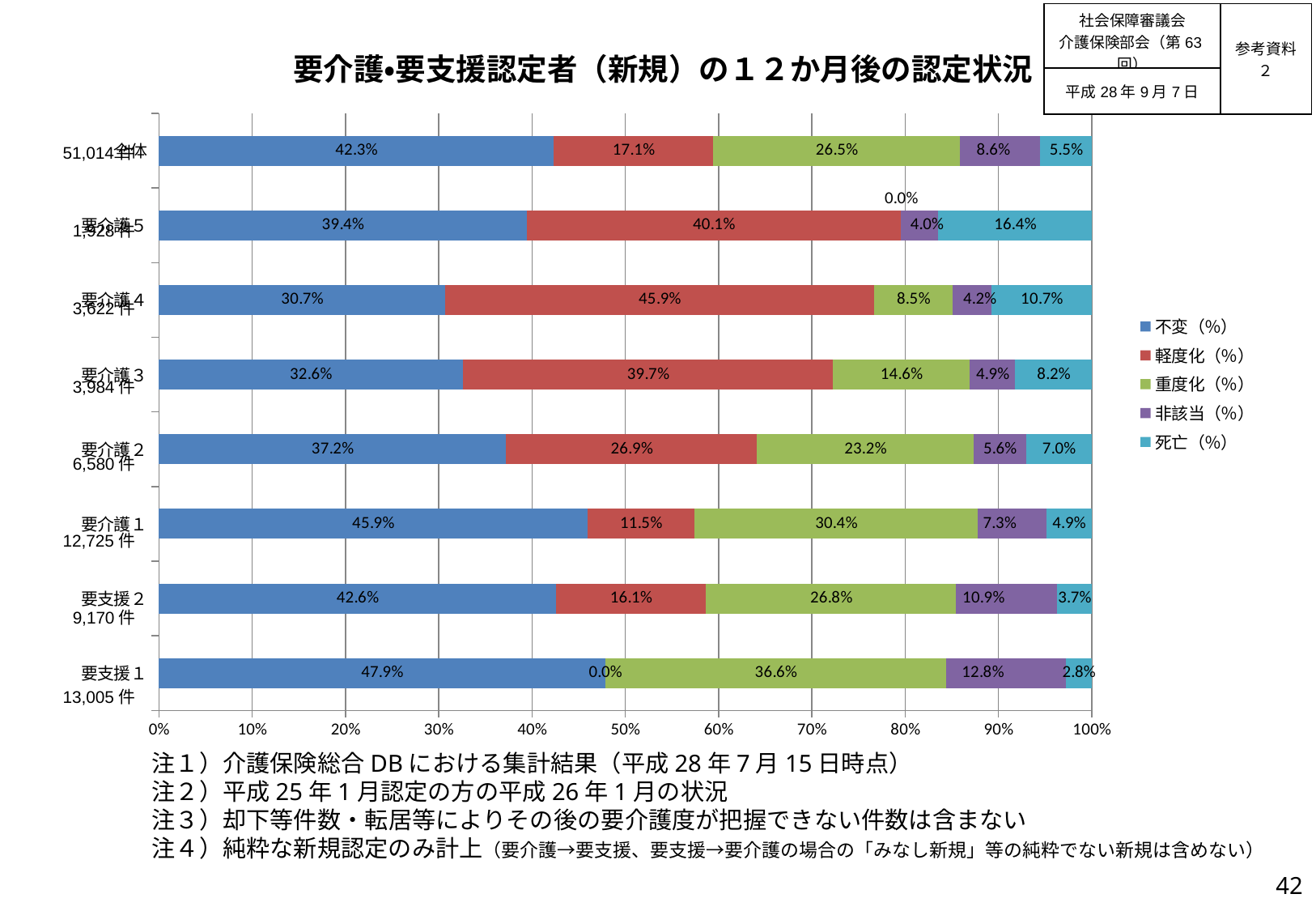
What kind of chart is shown on the slide? stacked bar chart Which is larger, the 非該当（%） value for 要支援2 or for 要介護1? 要支援2 What colour represents the 軽度化（%） series in the legend? red Which category has the highest 不変（%） value? 要支援1 What is the 死亡（%） value for 要介護5? 16.4% What is the difference between the 重度化（%） values for 要介護1 and 要介護2? 7.2% How many categories (bars) are plotted in the chart? 8 What is the 不変（%） value for 全体? 42.3% Which category has the lowest 死亡（%） value? 要支援1 What is the 重度化（%） value for 要支援1? 36.6% How many series does the legend list? 5 What is the 軽度化（%） value for 要介護4? 45.9%